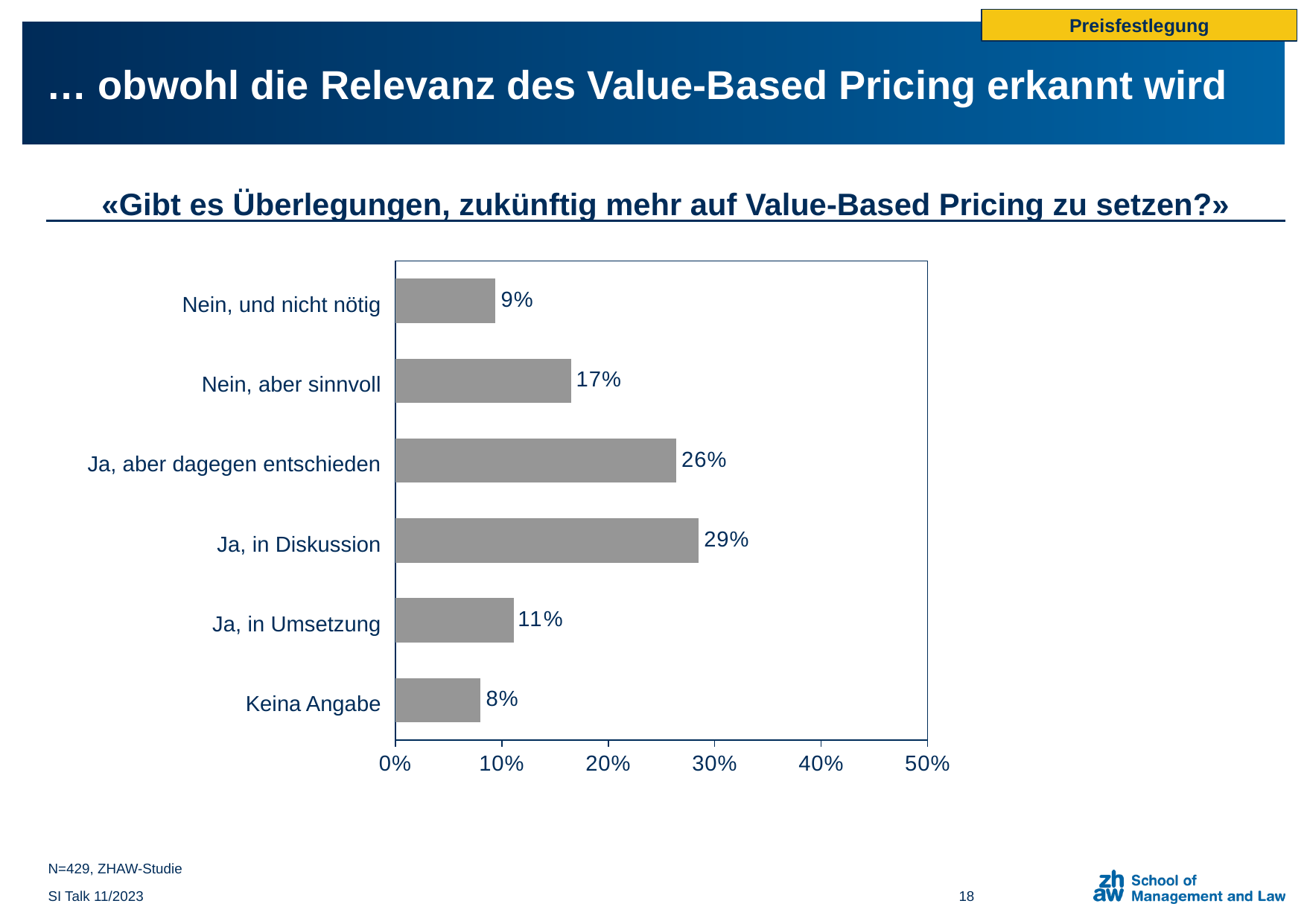
What is the difference between "Ja, aber dagegen entschieden" and "Nein, aber sinnvoll"? 9% What is the value for "Ja, in Umsetzung"? 11% How many categories are shown in the chart? 6 What is the highest value shown on the x axis? 50% Which category has the highest value? Ja, in Diskussion Which is larger, "Nein, und nicht nötig" or "Ja, in Umsetzung"? Ja, in Umsetzung What is the value for "Nein, aber sinnvoll"? 17% Is the value for "Ja, aber dagegen entschieden" greater or less than 20%? greater What is the value for "Ja, in Diskussion"? 29% What kind of chart is shown on the slide? Bar chart Which category has the lowest value? Keina Angabe What is the value for "Keina Angabe"? 8%